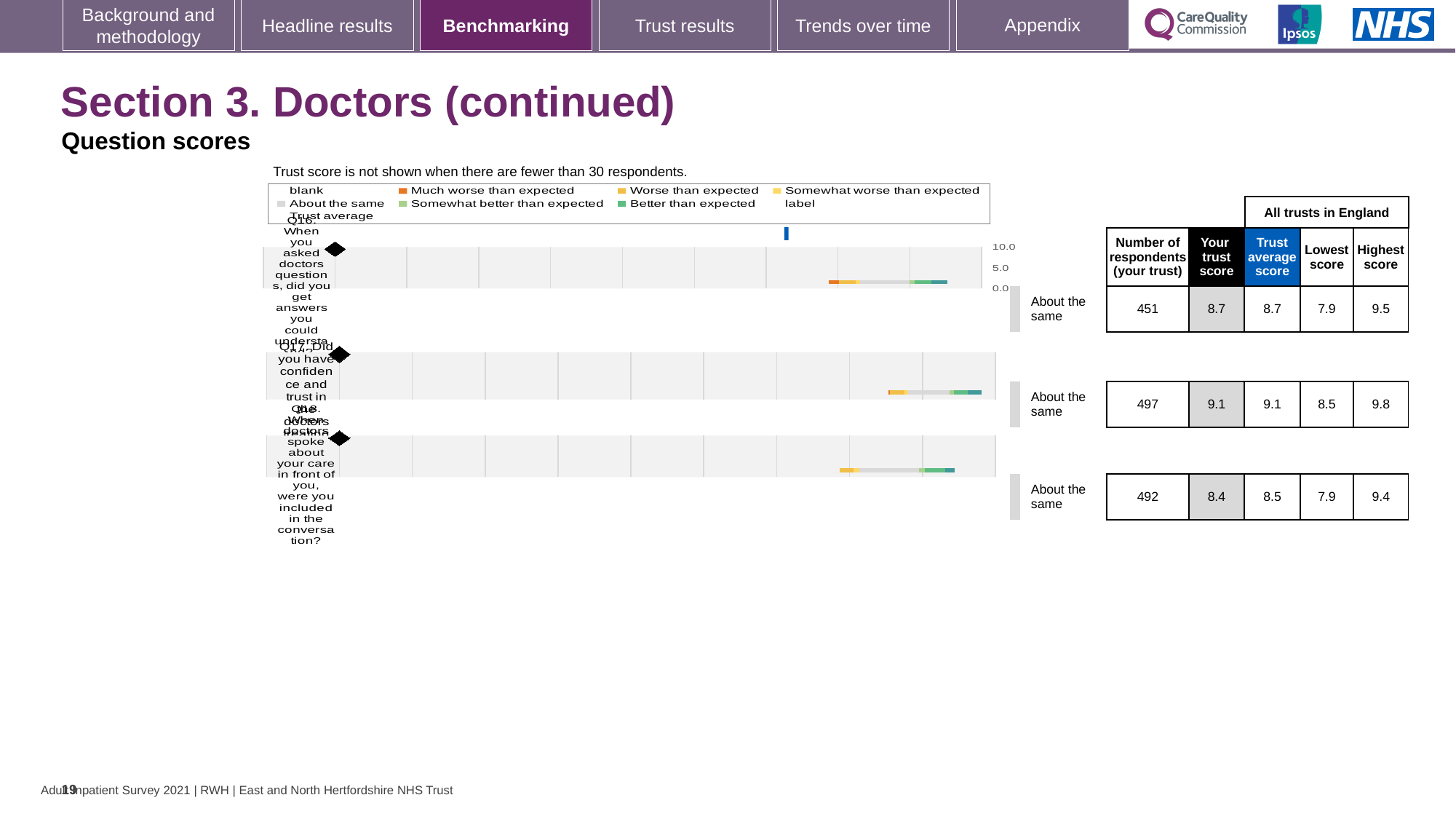
Which question has the highest 'Your trust score'? Q17 For Q18, which is larger: your trust score or the trust average score? Trust average score Which question has the lowest 'Your trust score'? Q18 What kind of chart is used to show the question scores on this slide? bar chart What is the number of respondents (your trust) for Q17? 497 How many questions are plotted in the chart? 3 According to the note above the chart, below how many respondents is the trust score not shown? 30 What is the number of respondents (your trust) for Q16? 451 What is your trust score for Q17? 9.1 What benchmark category is shown for Q16? About the same For Q17, what is the difference between the highest score and the lowest score across all trusts in England? 1.3 What is the highest score across all trusts in England for Q18? 9.4